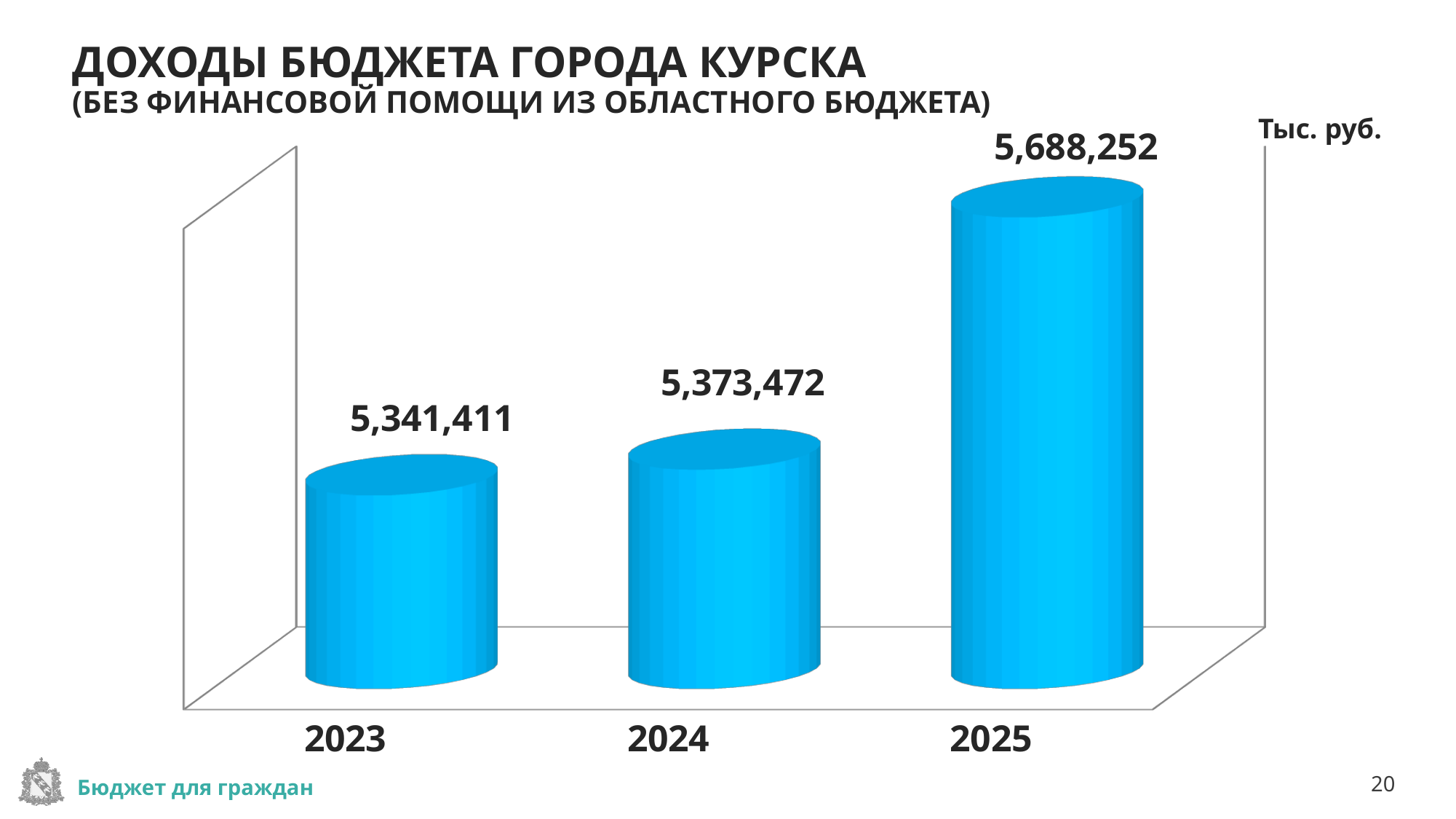
Do the values rise or fall from 2023 to 2025? Rise Which year has the highest value? 2025 What is the value for 2023? 5,341,411 What is the difference between the values for 2024 and 2023? 32,061 What is the difference between the values for 2025 and 2023? 346,841 Which is larger, the value for 2025 or the value for 2023? 2025 What kind of chart is shown on the slide? Bar chart What is the value for 2025? 5,688,252 Which year has the lowest value? 2023 How many years are shown on the chart? 3 What is the difference between the values for 2025 and 2024? 314,780 What is the value for 2024? 5,373,472